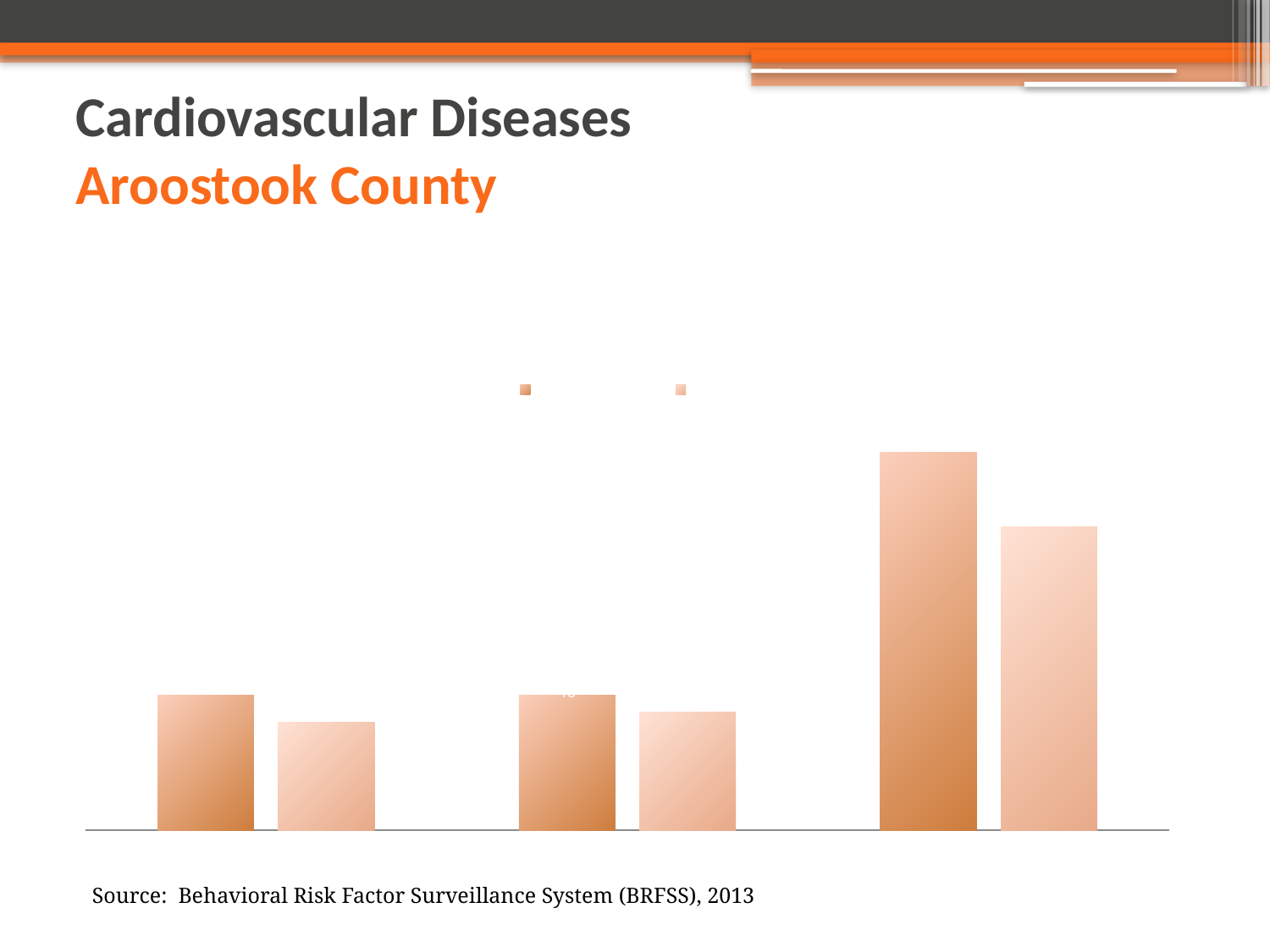
How many groups of bars does the chart show? 3 How many bars are plotted in total on the chart? 6 What county does the slide title say the chart is about? Aroostook County Which group of bars, by position from left to right, has the tallest bars? the rightmost (third) group How many series does the legend list? 2 Is the darker orange bar in each group taller or shorter than the lighter bar next to it? taller What is the source cited below the chart? Behavioral Risk Factor Surveillance System (BRFSS), 2013 What kind of chart is shown on the slide? bar chart In the rightmost group of bars, is the darker orange bar or the lighter orange bar taller? the darker orange bar In the leftmost group of bars, is the darker orange bar or the lighter orange bar taller? the darker orange bar